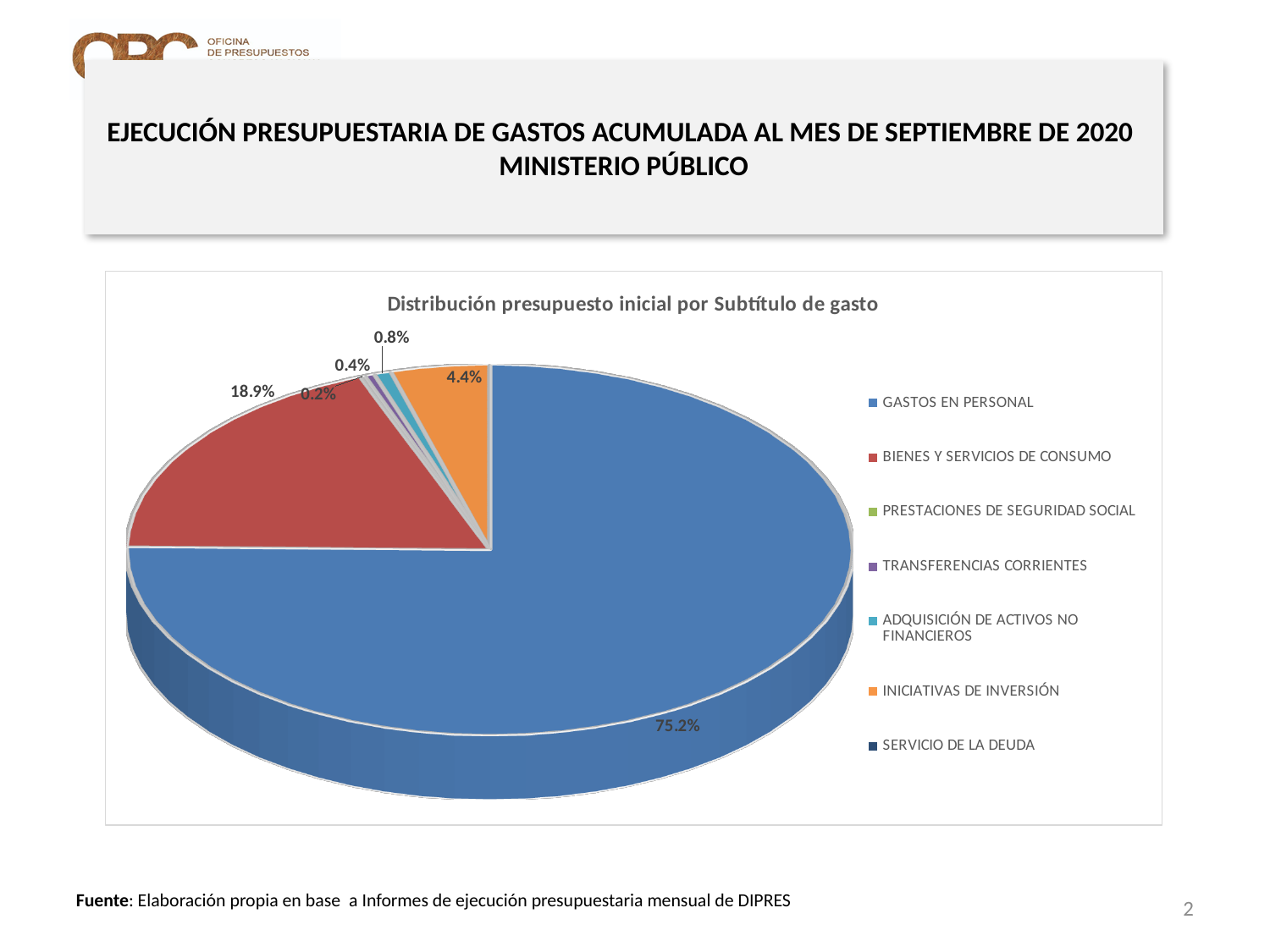
What share of the pie does BIENES Y SERVICIOS DE CONSUMO represent? 18.9% What share of the pie does GASTOS EN PERSONAL represent? 75.2% What share of the pie does ADQUISICIÓN DE ACTIVOS NO FINANCIEROS represent? 0.8% What is the title of the chart? Distribución presupuesto inicial por Subtítulo de gasto How many categories does the legend list? 7 Which category has the largest slice of the pie? GASTOS EN PERSONAL What is the combined share of GASTOS EN PERSONAL and BIENES Y SERVICIOS DE CONSUMO? 94.1% What kind of chart is shown on the slide? pie chart Which is larger, the slice for BIENES Y SERVICIOS DE CONSUMO or the slice for INICIATIVAS DE INVERSIÓN? BIENES Y SERVICIOS DE CONSUMO What share of the pie does INICIATIVAS DE INVERSIÓN represent? 4.4% What is the difference in percentage points between the GASTOS EN PERSONAL slice and the BIENES Y SERVICIOS DE CONSUMO slice? 56.3 percentage points What colour is the slice for GASTOS EN PERSONAL? blue